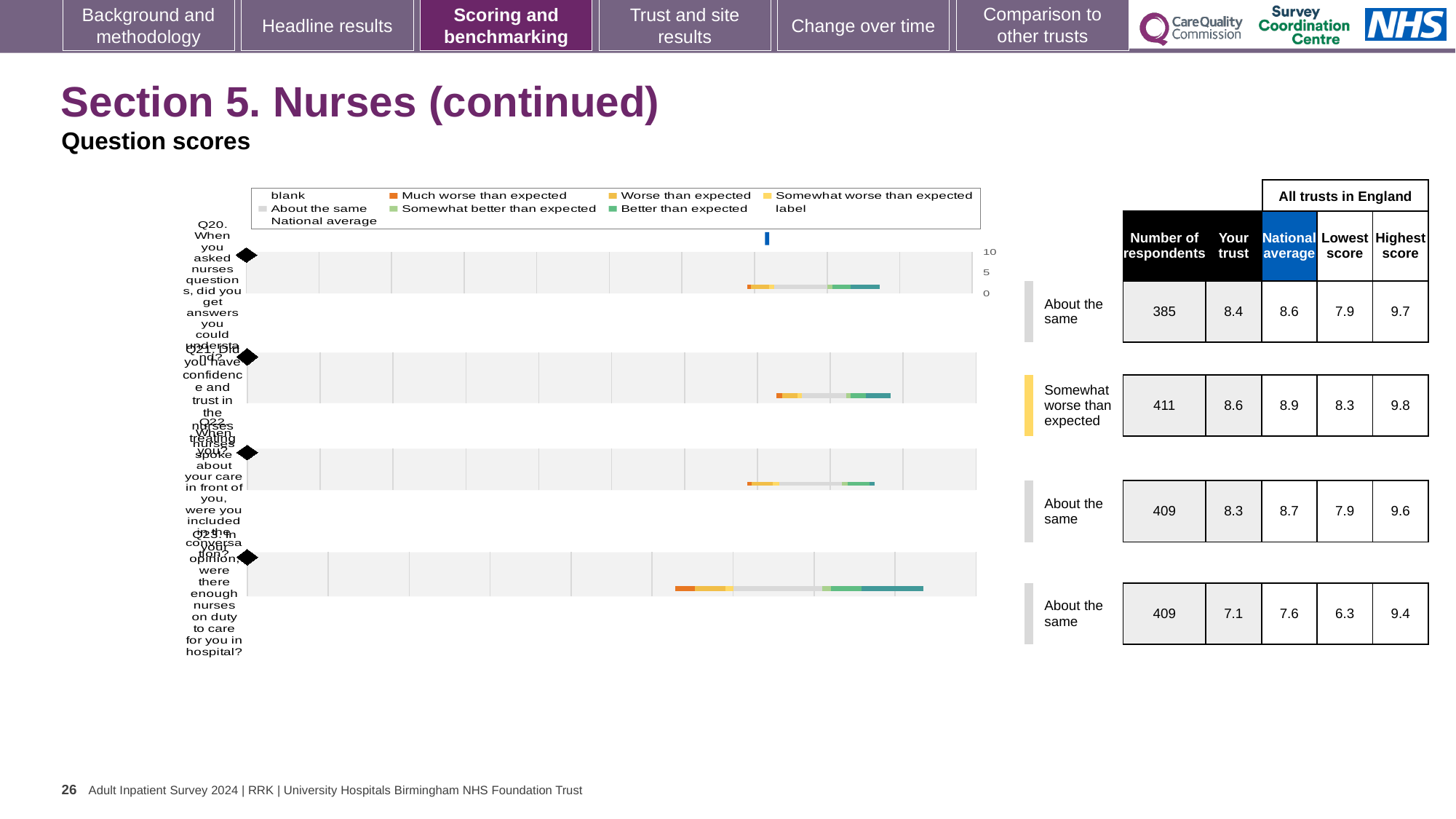
How many questions are plotted in the chart? 4 What is the national average score for Q23 (were there enough nurses on duty to care for you in hospital)? 7.6 Which benchmark category is shown for Q21? Somewhat worse than expected What kind of chart is used to show the question scores? Bar chart Which question has the highest 'Your trust' score? Q21 What is the highest score across all trusts in England for Q22? 9.6 For Q21, how much higher is the national average than the 'Your trust' score? 0.3 What is the 'Your trust' score for Q20 (When you asked nurses questions, did you get answers you could understand)? 8.4 Which has the larger 'Your trust' score, Q20 or Q22? Q20 For Q23, what is the difference between the highest score and the lowest score across all trusts in England? 3.1 How many respondents answered Q21 (Did you have confidence and trust in the nurses treating you)? 411 Which question has the lowest 'Your trust' score? Q23